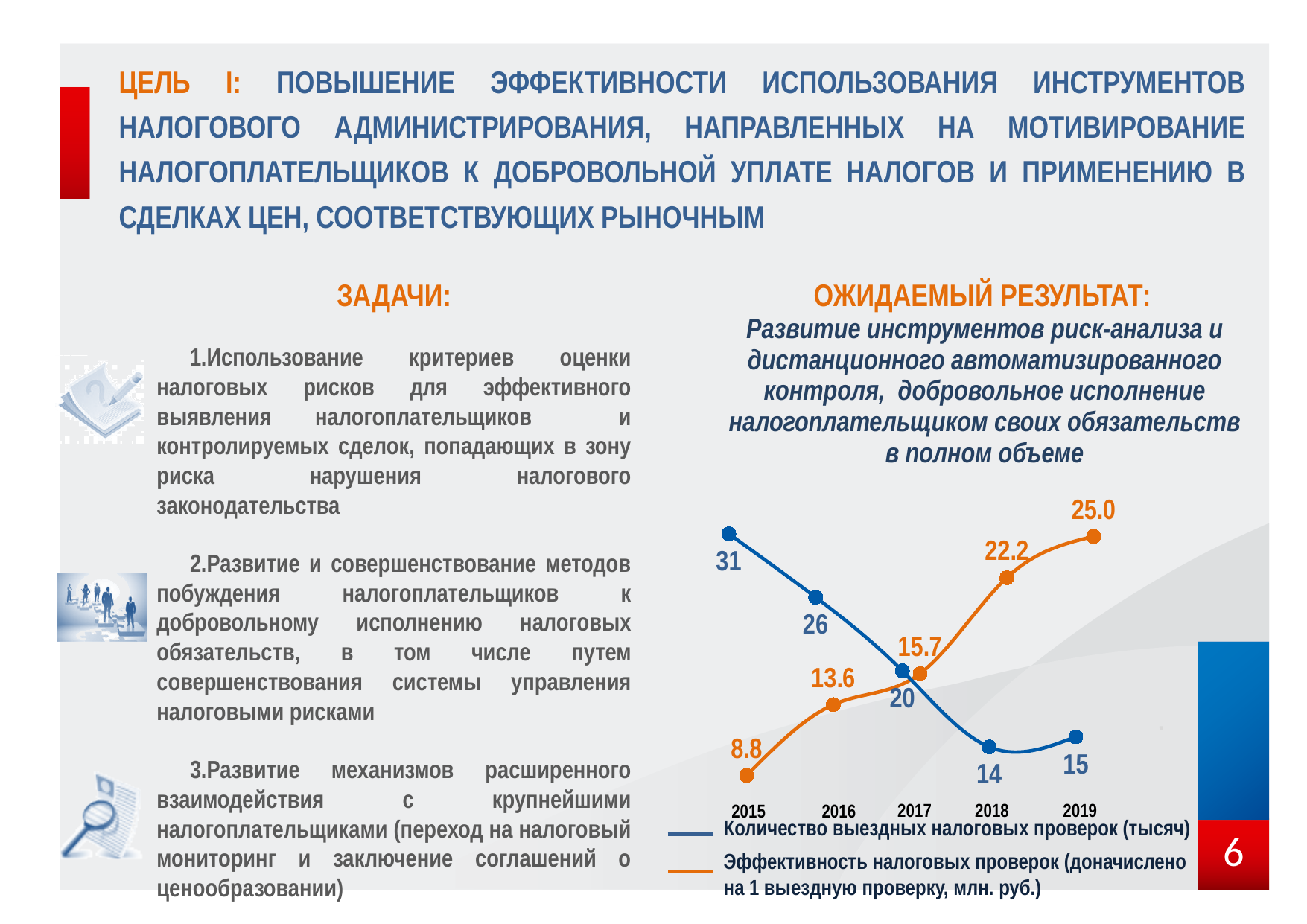
How many series does the chart legend list? 2 How many years are plotted on the x axis of the chart? 5 What type of chart is shown on the slide? line chart In which year is 'Количество выездных налоговых проверок (тысяч)' lowest? 2018 What is the difference between the 2019 and 2015 values of 'Эффективность налоговых проверок'? 16.2 Does 'Эффективность налоговых проверок' rise or fall from 2015 to 2019? rise What is the value of 'Количество выездных налоговых проверок (тысяч)' in 2015? 31 What is the value of 'Эффективность налоговых проверок' in 2019? 25.0 What is the value of 'Эффективность налоговых проверок' in 2017? 15.7 In which year is 'Эффективность налоговых проверок' highest? 2019 Which is larger in 2016: 'Количество выездных налоговых проверок (тысяч)' or 'Эффективность налоговых проверок'? Количество выездных налоговых проверок (тысяч) What is the difference between the 2015 and 2019 values of 'Количество выездных налоговых проверок (тысяч)'? 16